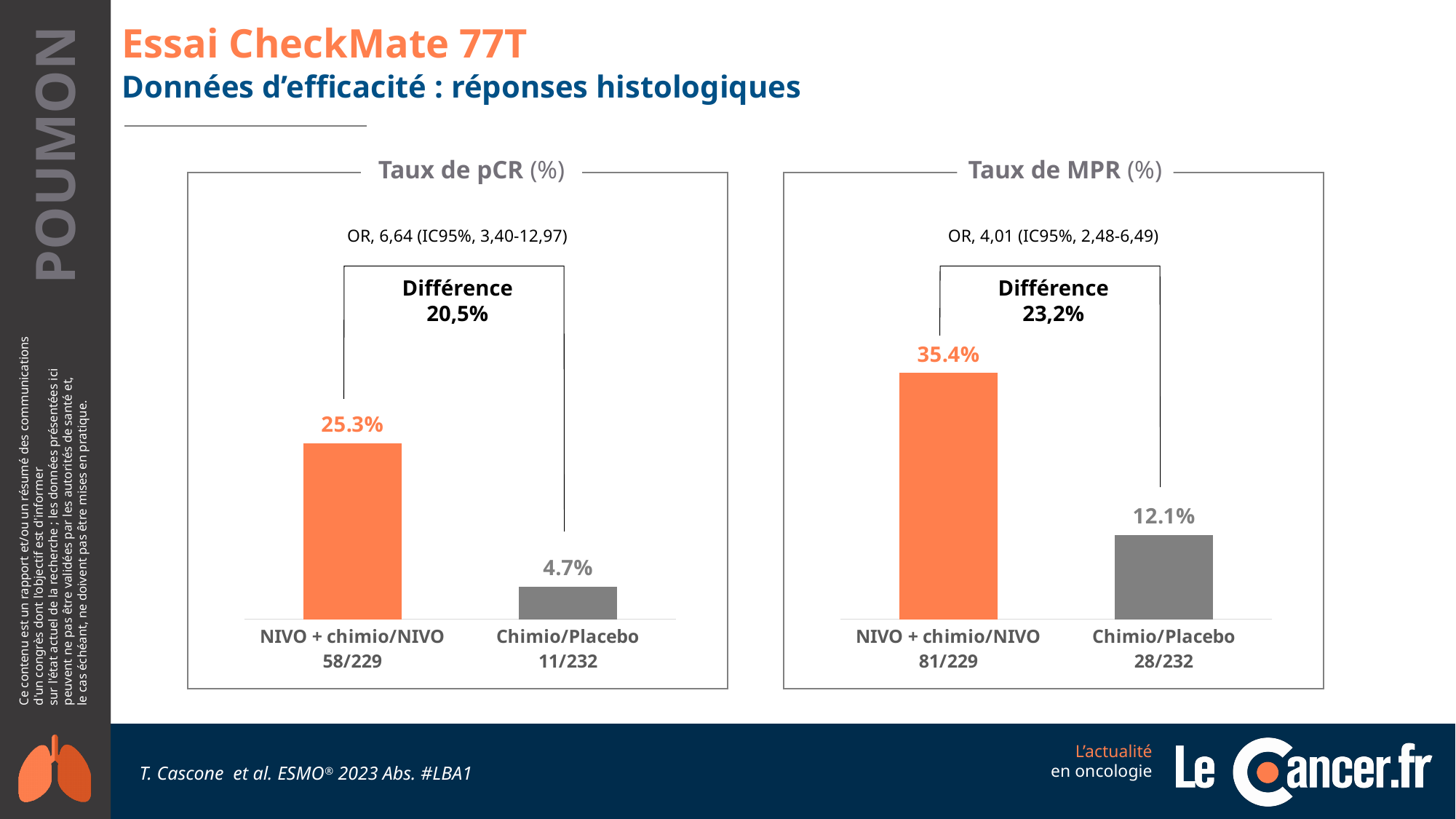
In the 'Taux de pCR (%)' chart, which category has the highest value? NIVO + chimio/NIVO How many categories are shown in the 'Taux de pCR (%)' chart? 2 In the 'Taux de MPR (%)' chart, what is the value for NIVO + chimio/NIVO? 35.4% In the 'Taux de MPR (%)' chart, which category has the lowest value? Chimio/Placebo In the 'Taux de pCR (%)' chart, what odds ratio is printed above the bars? OR, 6,64 (IC95%, 3,40-12,97) In the 'Taux de MPR (%)' chart, which is larger: NIVO + chimio/NIVO or Chimio/Placebo? NIVO + chimio/NIVO What kind of chart is the 'Taux de MPR (%)' chart? Bar chart In the 'Taux de MPR (%)' chart, what is the value for Chimio/Placebo? 12.1% In the 'Taux de pCR (%)' chart, what is the value for NIVO + chimio/NIVO? 25.3% In the 'Taux de pCR (%)' chart, what is the value for Chimio/Placebo? 4.7% In the 'Taux de pCR (%)' chart, what is the difference between NIVO + chimio/NIVO and Chimio/Placebo? 20,5% In the 'Taux de MPR (%)' chart, what is the difference between NIVO + chimio/NIVO and Chimio/Placebo? 23,2%